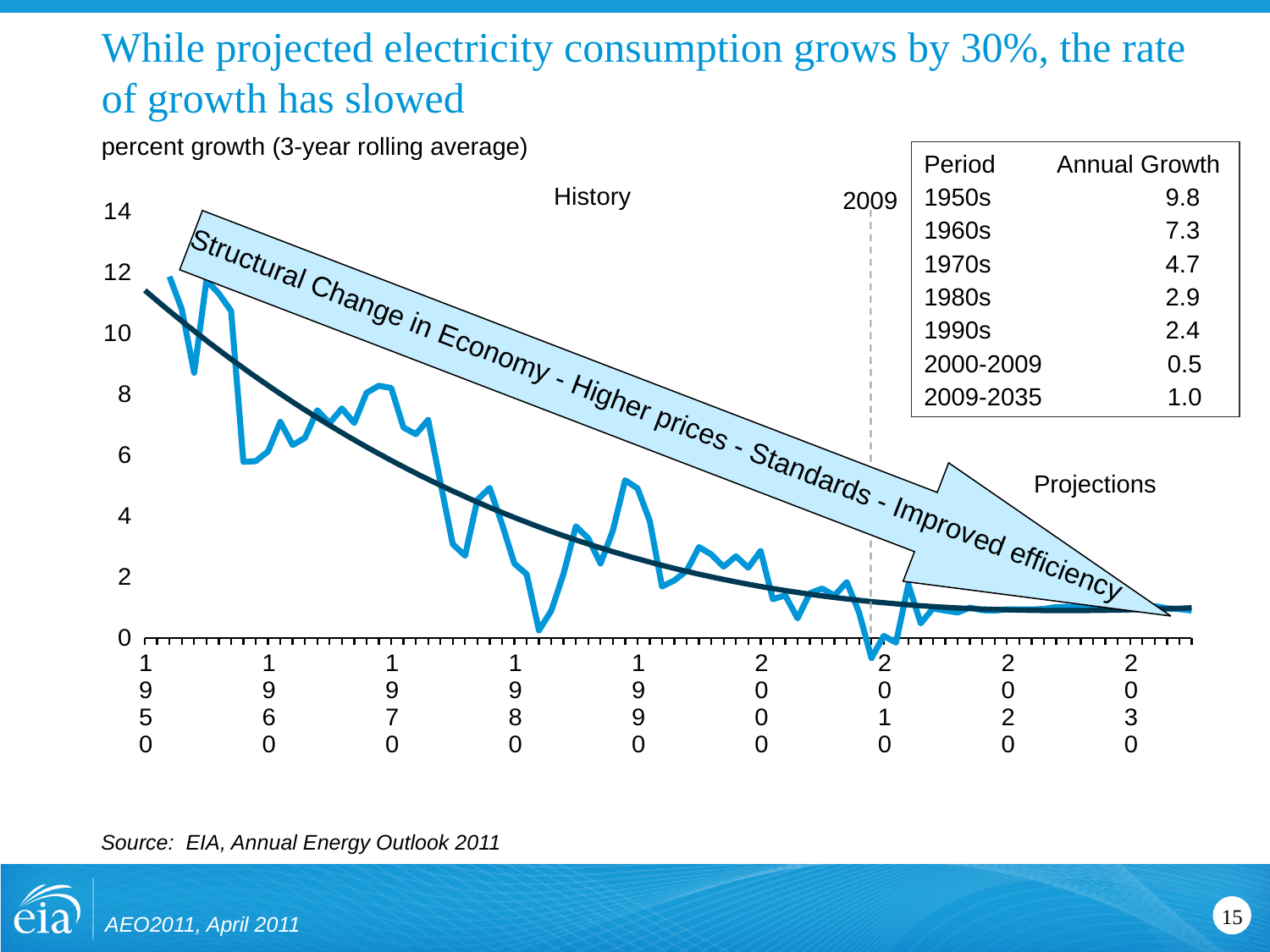
What kind of chart is shown on the slide? line chart Is the plotted percent growth at 1950 greater or less than 10? greater What is the difference between the annual growth for the 1950s and the 1960s in the table? 2.5 Which period in the table has the highest annual growth? 1950s Is the plotted percent growth at 2030 greater or less than 2? less Which period has the larger annual growth in the table, the 1980s or the 1990s? 1980s Does the plotted percent growth generally rise or fall from 1950 to 2030? fall How many periods are listed in the Annual Growth table? 7 According to the table, what is the annual growth for the 2009-2035 period? 1.0 What year does the dashed vertical line separating History from Projections mark? 2009 According to the table, what is the annual growth for the 1950s? 9.8 Which period in the table has the lowest annual growth? 2000-2009